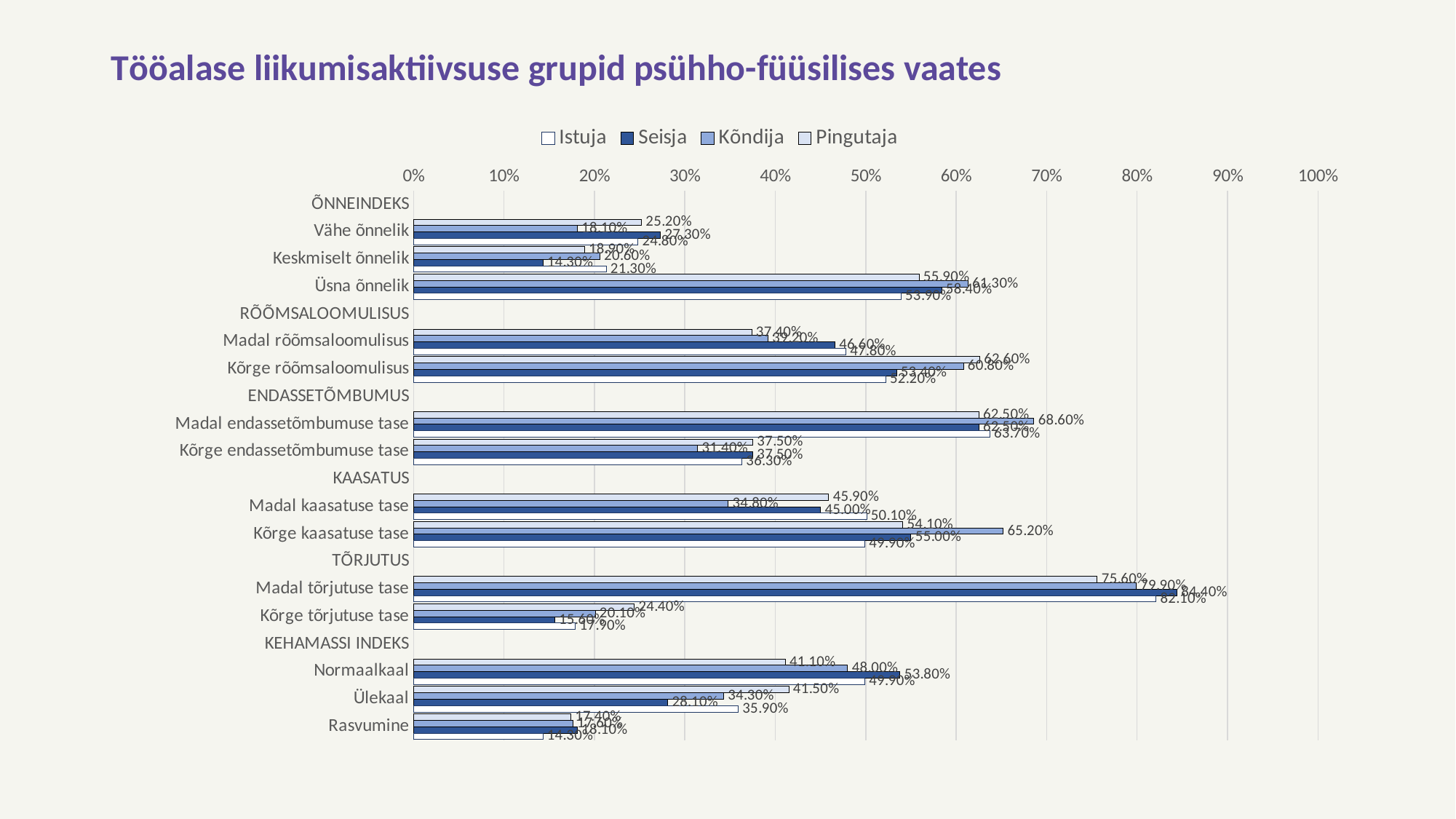
What is the value for Istuja in the Ülekaal category? 35.90% What kind of chart is shown on the slide? bar chart Which series has the highest value in the Kõrge kaasatuse tase category? Kõndija Which series has the highest value in the Madal tõrjutuse tase category? Seisja What is the value for Pingutaja in the Madal tõrjutuse tase category? 75.60% What is the value for Seisja in the Madal endassetõmbumuse tase category? 62.50% What is the difference between the Seisja and Pingutaja values in the Madal tõrjutuse tase category? 8.80% What is the value for Seisja in the Madal tõrjutuse tase category? 84.40% Is the value for Seisja in the Madal tõrjutuse tase category greater or less than 80%? greater What is the value for Kõndija in the Kõrge kaasatuse tase category? 65.20% In the Ülekaal category, which is larger: the Istuja value or the Seisja value? Istuja How many series does the legend list? 4